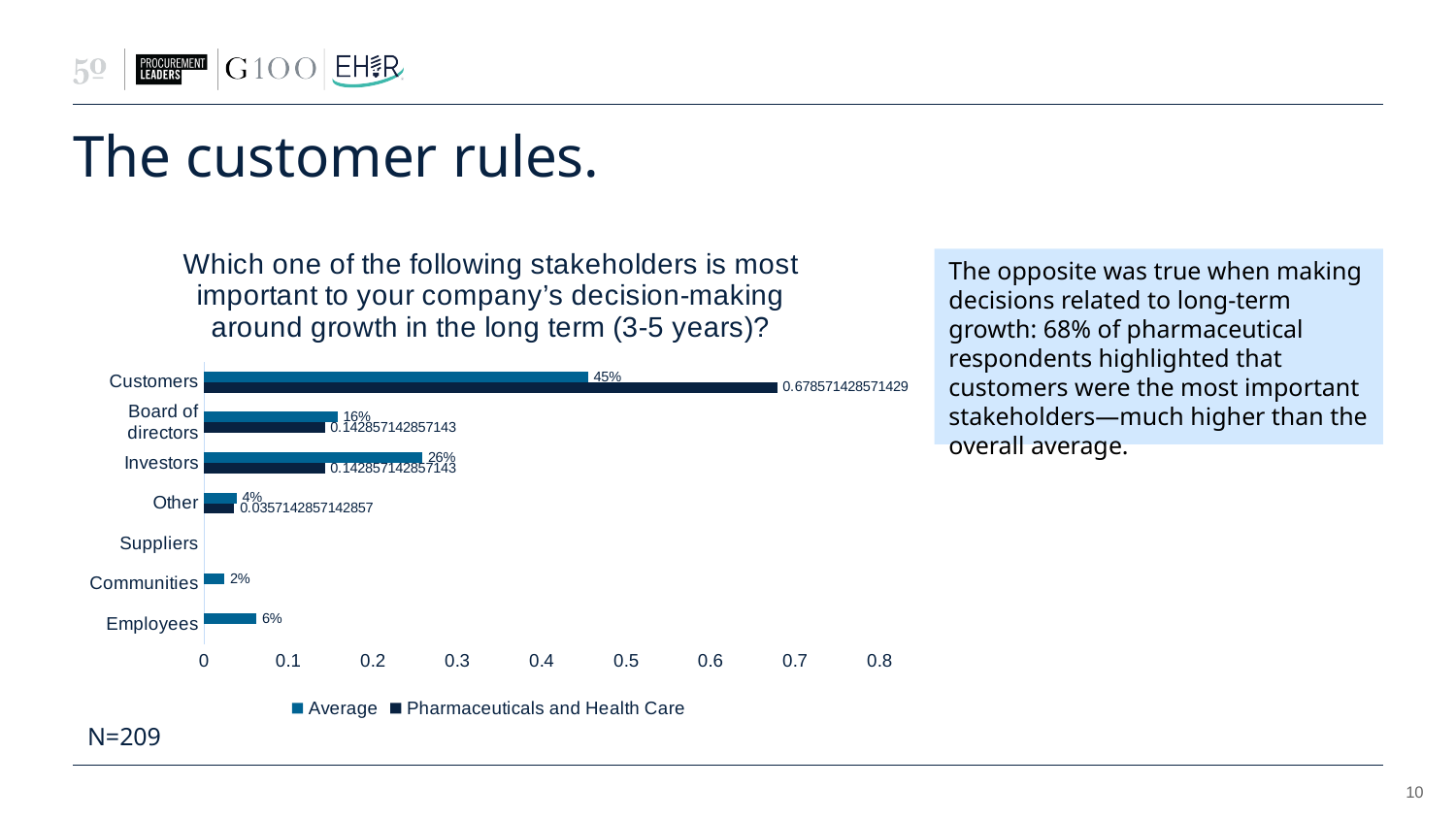
Which is larger for Investors: the Average value or the Pharmaceuticals and Health Care value? Average What is the Pharmaceuticals and Health Care value for Customers? 0.678571428571429 Which of the labelled stakeholders has the lowest Average value? Communities Which stakeholder has the highest Average value? Customers What is the Average value for Customers? 45% What is the Average value for Investors? 26% How many series does the chart legend list? 2 How many stakeholder categories are shown on the chart's vertical axis? 7 What is the Pharmaceuticals and Health Care value for Other? 0.0357142857142857 What type of chart is shown on the slide? bar chart What is the difference between the Average values for Investors and Board of directors? 10% What is the Average value for Employees? 6%